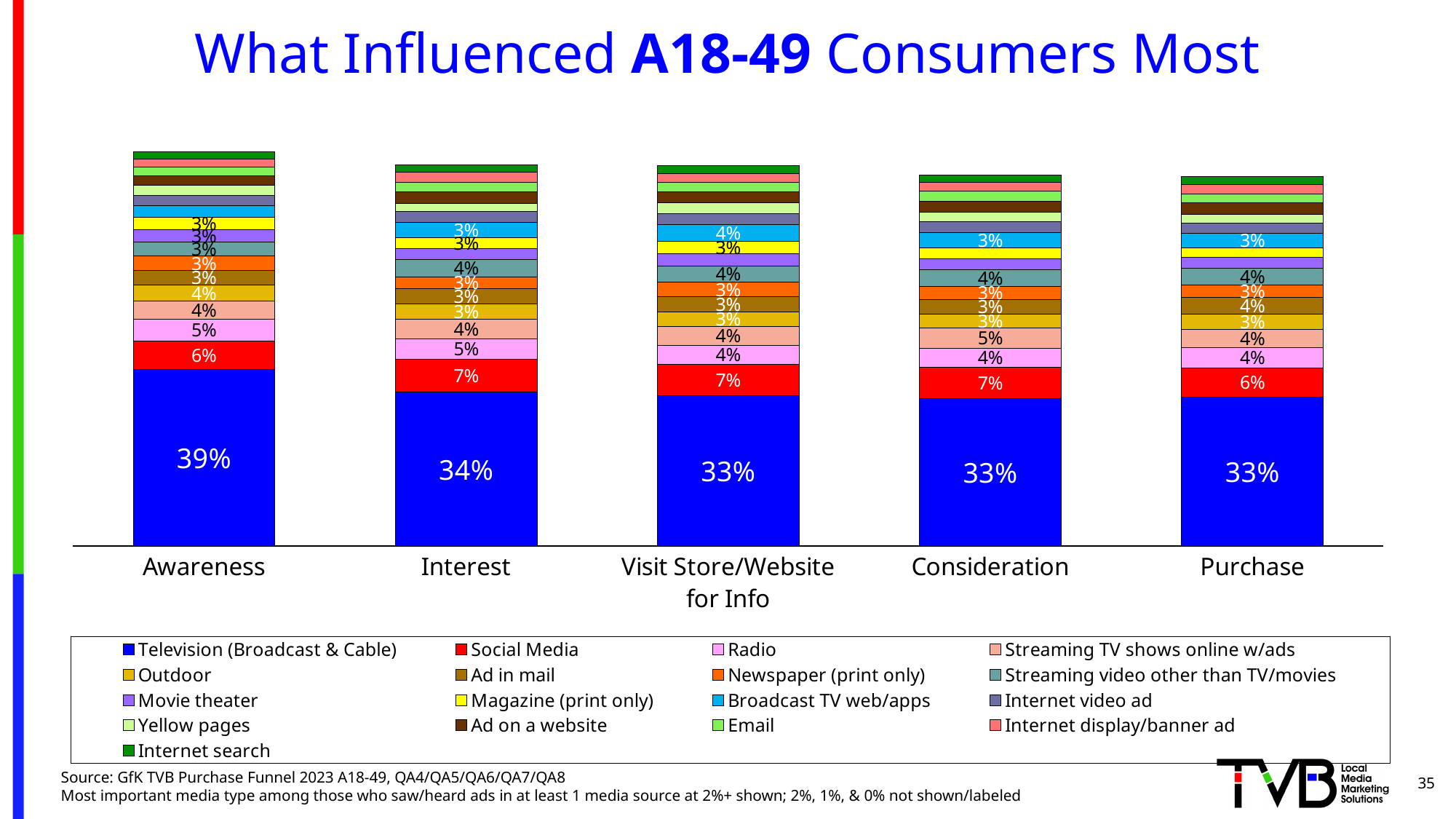
What is the value for Television (Broadcast & Cable) in the Awareness bar? 39% What kind of chart is shown on the slide? Stacked bar chart What is the difference between the Television (Broadcast & Cable) values for Awareness and Interest? 5 percentage points What is the value for Streaming TV shows online w/ads in the Consideration bar? 5% How many media types does the legend list? 17 What is the value for Radio in the Awareness bar? 5% What is the value for Broadcast TV web/apps in the Visit Store/Website for Info bar? 4% How many purchase funnel stages (categories) are shown along the x axis? 5 In which stage is the Television (Broadcast & Cable) value highest? Awareness Which is larger, the Social Media value for Awareness or for Interest? Interest What is the value for Social Media in the Interest bar? 7% What colour represents Television (Broadcast & Cable) in the chart? Blue